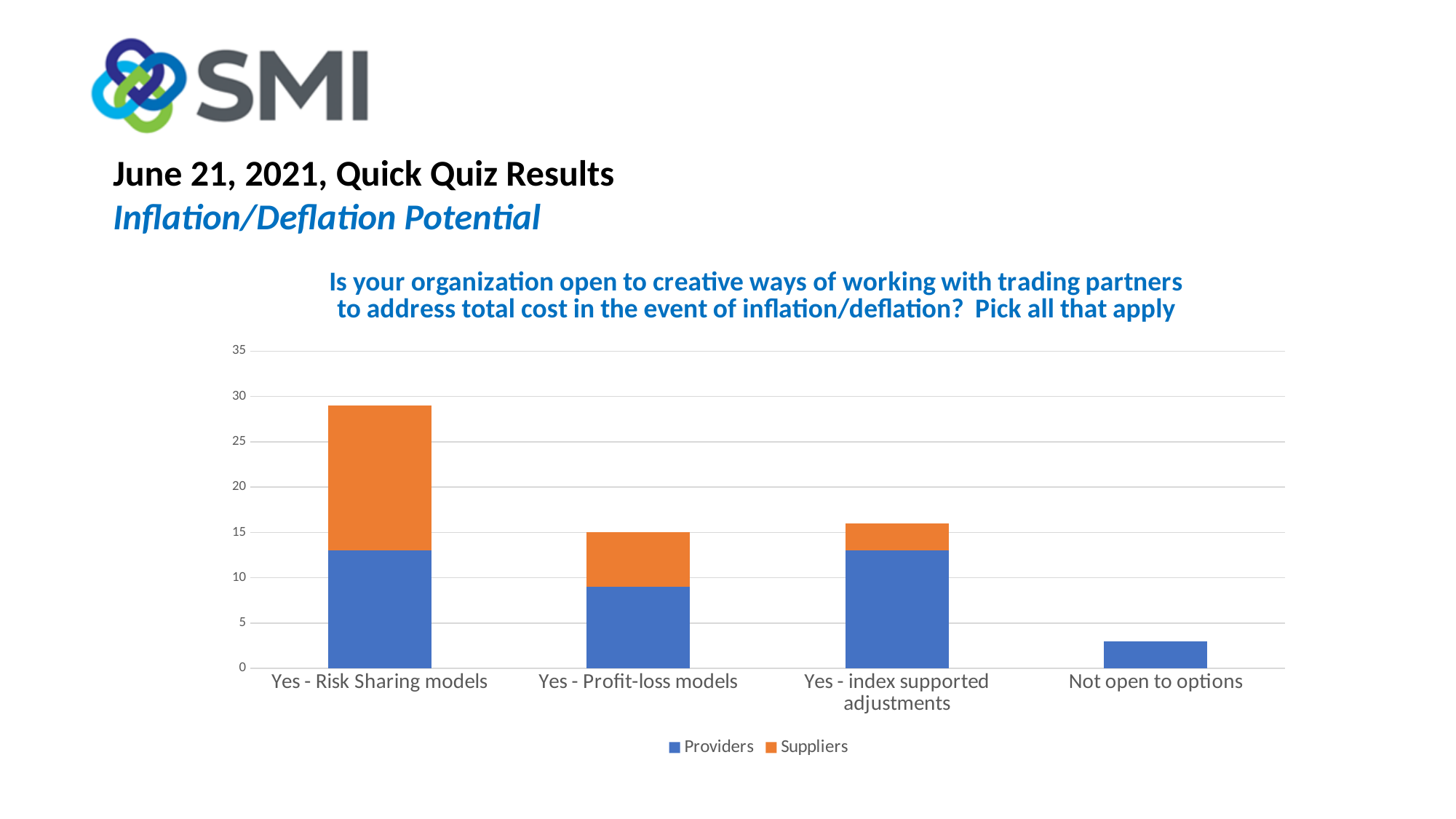
What kind of chart is shown on the slide? Stacked bar chart How many series does the chart's legend list? 2 Is the total bar for Not open to options greater or less than 5? less Which category has the larger Suppliers value, Yes - Risk Sharing models or Yes - index supported adjustments? Yes - Risk Sharing models Which colour represents the Suppliers series in the chart? Orange Is the total bar for Yes - Risk Sharing models greater or less than 25? greater Is the total bar for Yes - index supported adjustments greater or less than 10? greater Which has the larger total bar, Yes - Risk Sharing models or Yes - Profit-loss models? Yes - Risk Sharing models How many categories are shown on the x axis of the chart? 4 Which category has the highest total bar? Yes - Risk Sharing models Which category has the lowest total bar? Not open to options